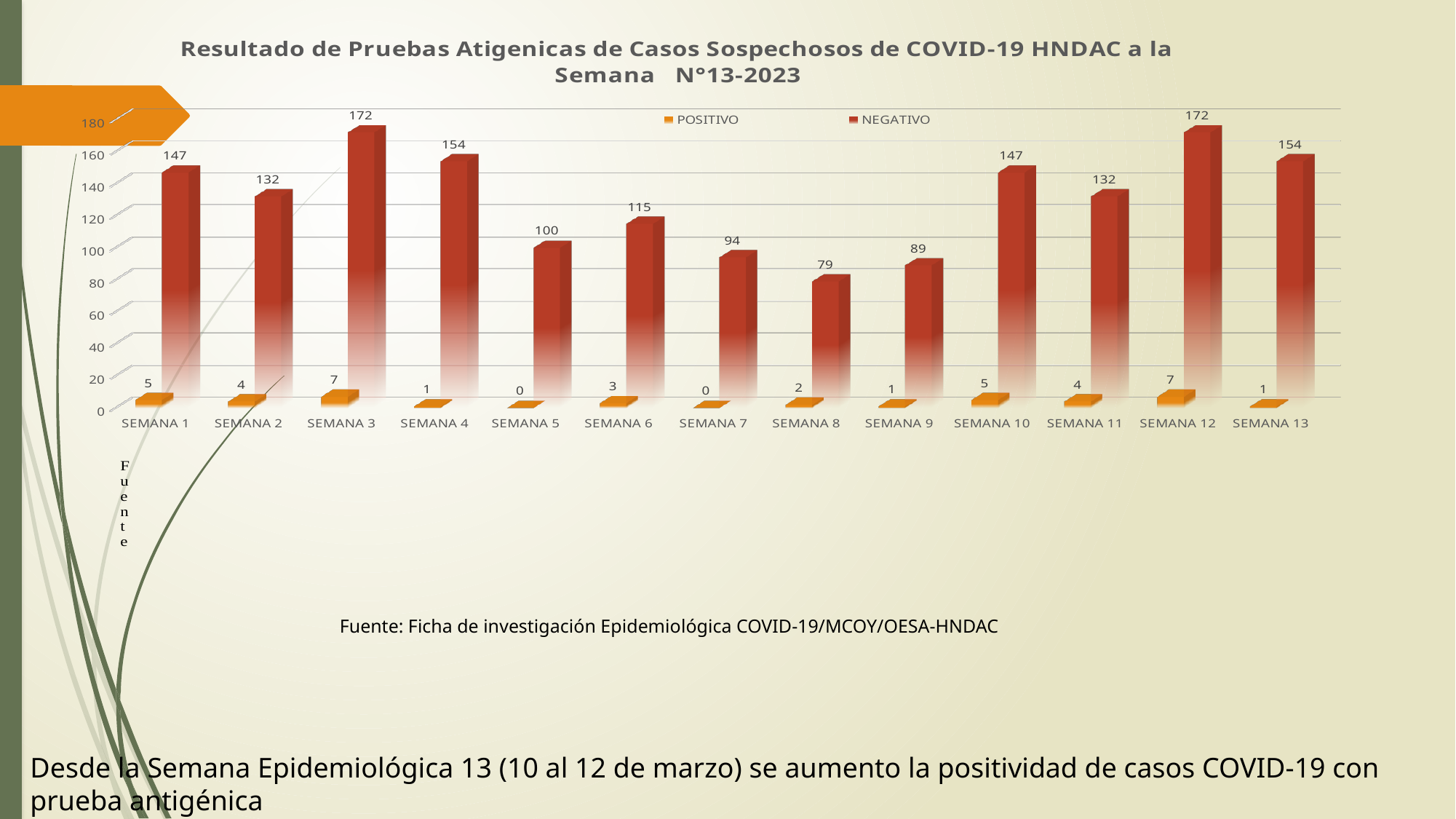
What kind of chart is shown on the slide? Bar chart Which is larger, the NEGATIVO value for SEMANA 6 or for SEMANA 9? SEMANA 6 Which week has the lowest NEGATIVO value? SEMANA 8 What is the POSITIVO value for SEMANA 10? 5 How many weeks (categories) are shown on the x axis? 13 How many series does the legend list? 2 Is the NEGATIVO value for SEMANA 7 greater or less than 100? less Do the NEGATIVO values rise or fall from SEMANA 8 to SEMANA 12? Rise What is the NEGATIVO value for SEMANA 8? 79 Which colour represents the POSITIVO series? Orange What is the difference between the NEGATIVO values for SEMANA 4 and SEMANA 5? 54 What is the NEGATIVO value for SEMANA 3? 172